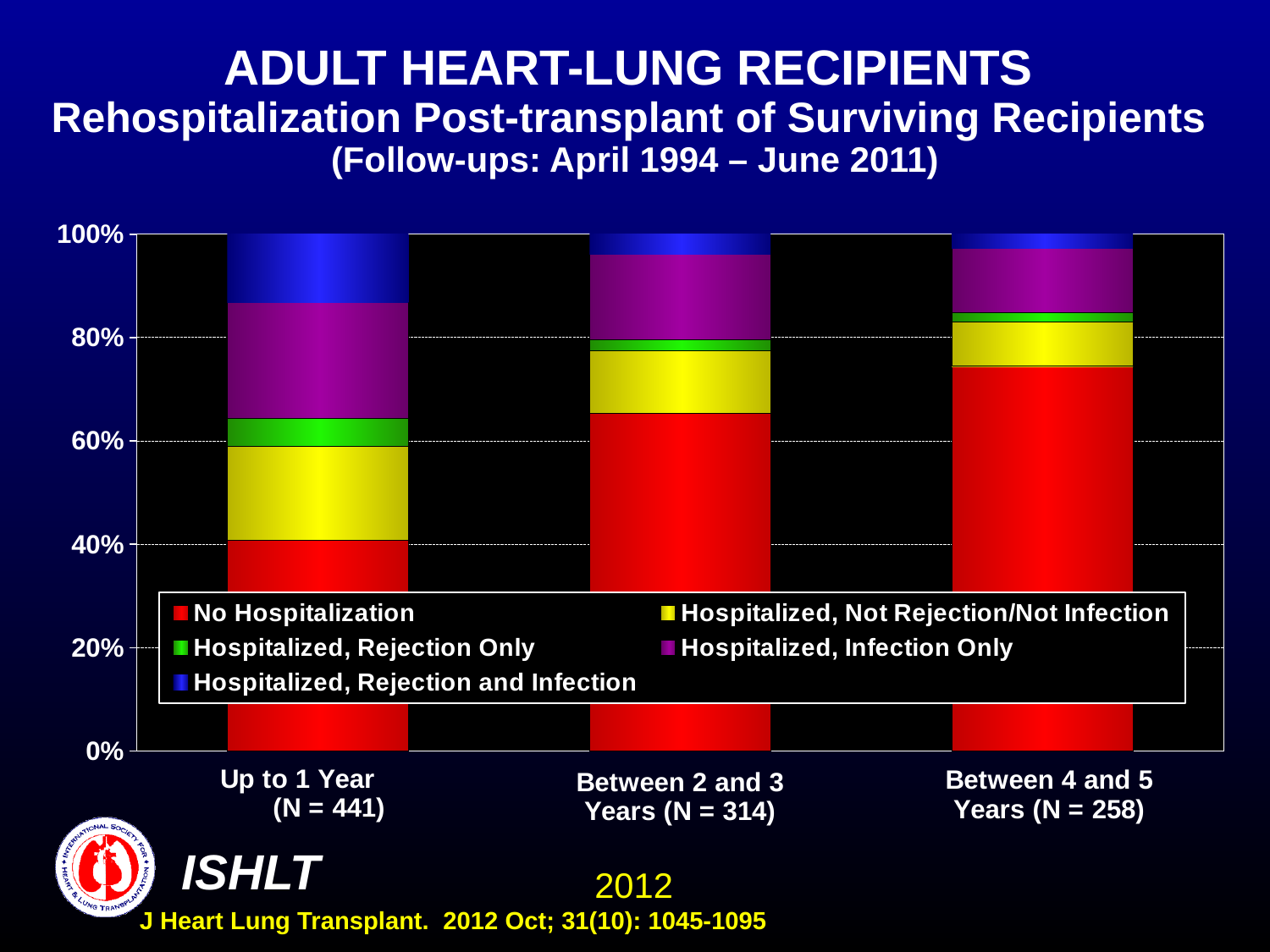
In which category is the No Hospitalization share the lowest? Up to 1 Year (N = 441) What is the N for the Between 2 and 3 Years category? 314 In which category is the No Hospitalization share the highest? Between 4 and 5 Years (N = 258) What is the total of the stacked bar for the Up to 1 Year category? 100% Does the No Hospitalization share rise or fall from Up to 1 Year to Between 4 and 5 Years? Rise How many follow-up time categories are shown on the x axis? 3 Which has a larger No Hospitalization share: Up to 1 Year or Between 2 and 3 Years? Between 2 and 3 Years Is the value for No Hospitalization in the Between 4 and 5 Years category greater or less than 80%? less Is the value for No Hospitalization in the Between 2 and 3 Years category greater or less than 60%? greater How many series does the legend list? 5 Is the value for No Hospitalization in the Up to 1 Year category greater or less than 60%? less What kind of chart is shown on the slide? Stacked bar chart